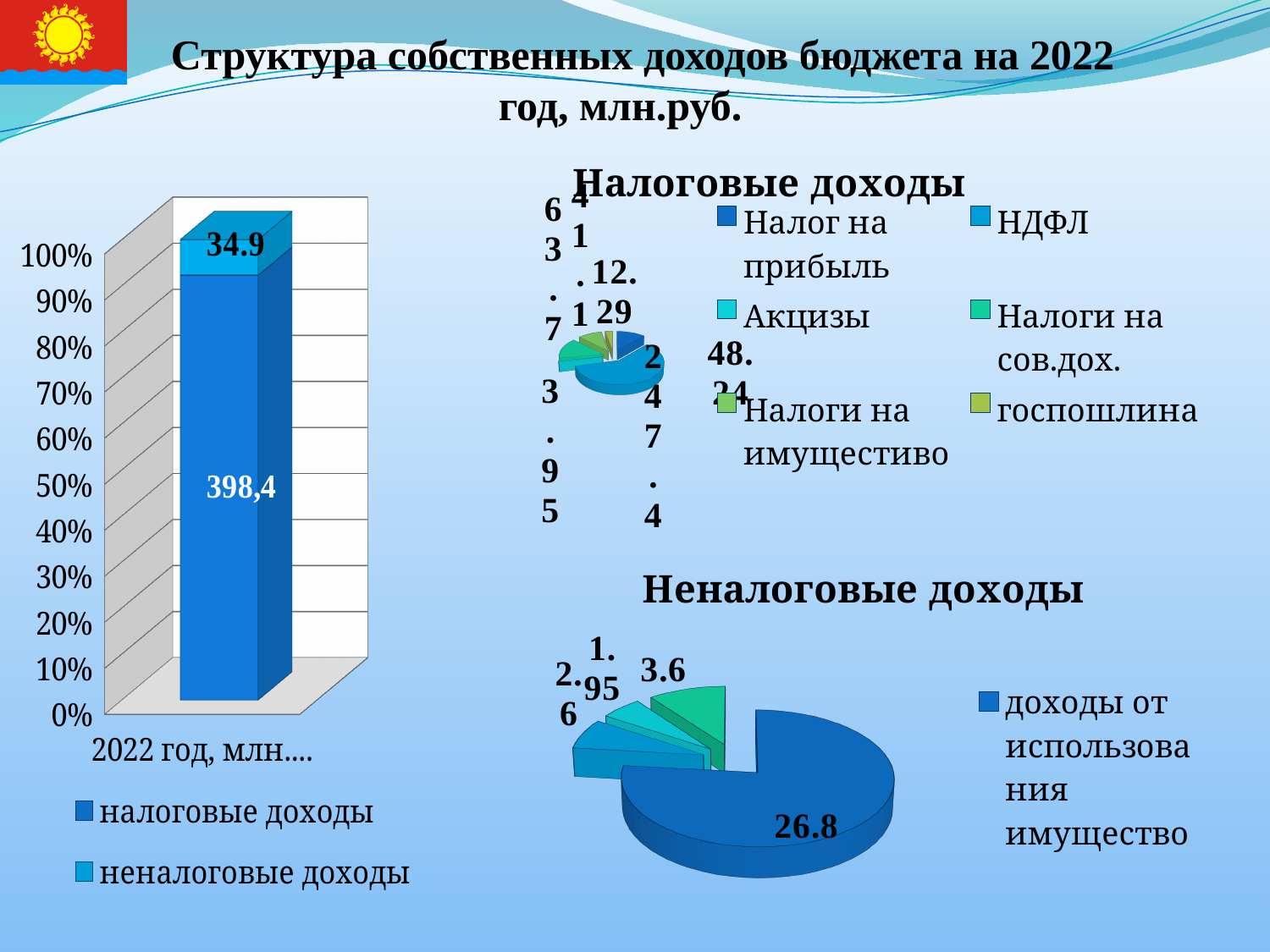
What kind of chart is the 'Налоговые доходы' chart? pie chart What is the title of the bottom-right pie chart? Неналоговые доходы How many series does the legend of the left bar chart list? 2 In the 'Неналоговые доходы' pie chart, what is the value of the green slice? 3.6 On the left bar chart, what is the value for неналоговые доходы? 34.9 In the 'Неналоговые доходы' pie chart, what is the value of the largest slice? 26.8 On the left bar chart, which is larger: налоговые доходы or неналоговые доходы? налоговые доходы How many entries does the legend of the 'Налоговые доходы' chart list? 6 In the 'Неналоговые доходы' pie chart, what is the difference between the slice labelled 26.8 and the slice labelled 3.6? 23.2 What kind of chart is the chart on the left of the slide? bar chart How many categories are shown on the x axis of the left bar chart? 1 On the left bar chart, what is the value for налоговые доходы? 398,4